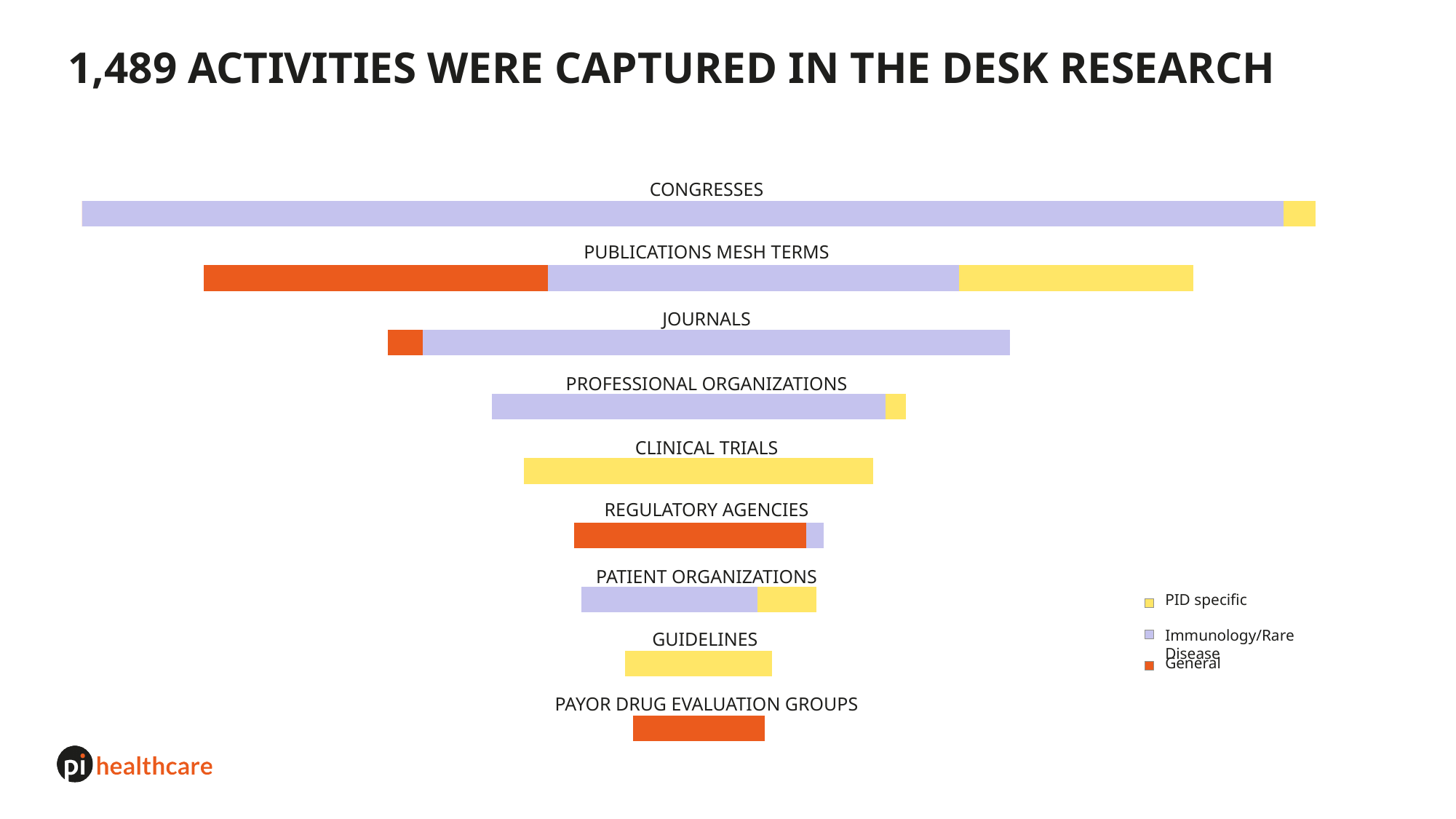
Which bar is longer, Clinical Trials or Guidelines? Clinical Trials Which series is shown in orange according to the legend? General Which category has the longest bar? Congresses Which series makes up the entire Clinical Trials bar? PID specific How many categories are shown in the chart? 9 Which bar is longer, Congresses or Journals? Congresses Which category's bar consists only of the General series? Payor Drug Evaluation Groups What kind of chart is shown on the slide? Stacked bar chart Which bar is longer, Publications Mesh Terms or Professional Organizations? Publications Mesh Terms What is the title of the slide? 1,489 ACTIVITIES WERE CAPTURED IN THE DESK RESEARCH Do the bar lengths generally increase or decrease from the top category to the bottom category? Decrease How many series does the legend list? 3